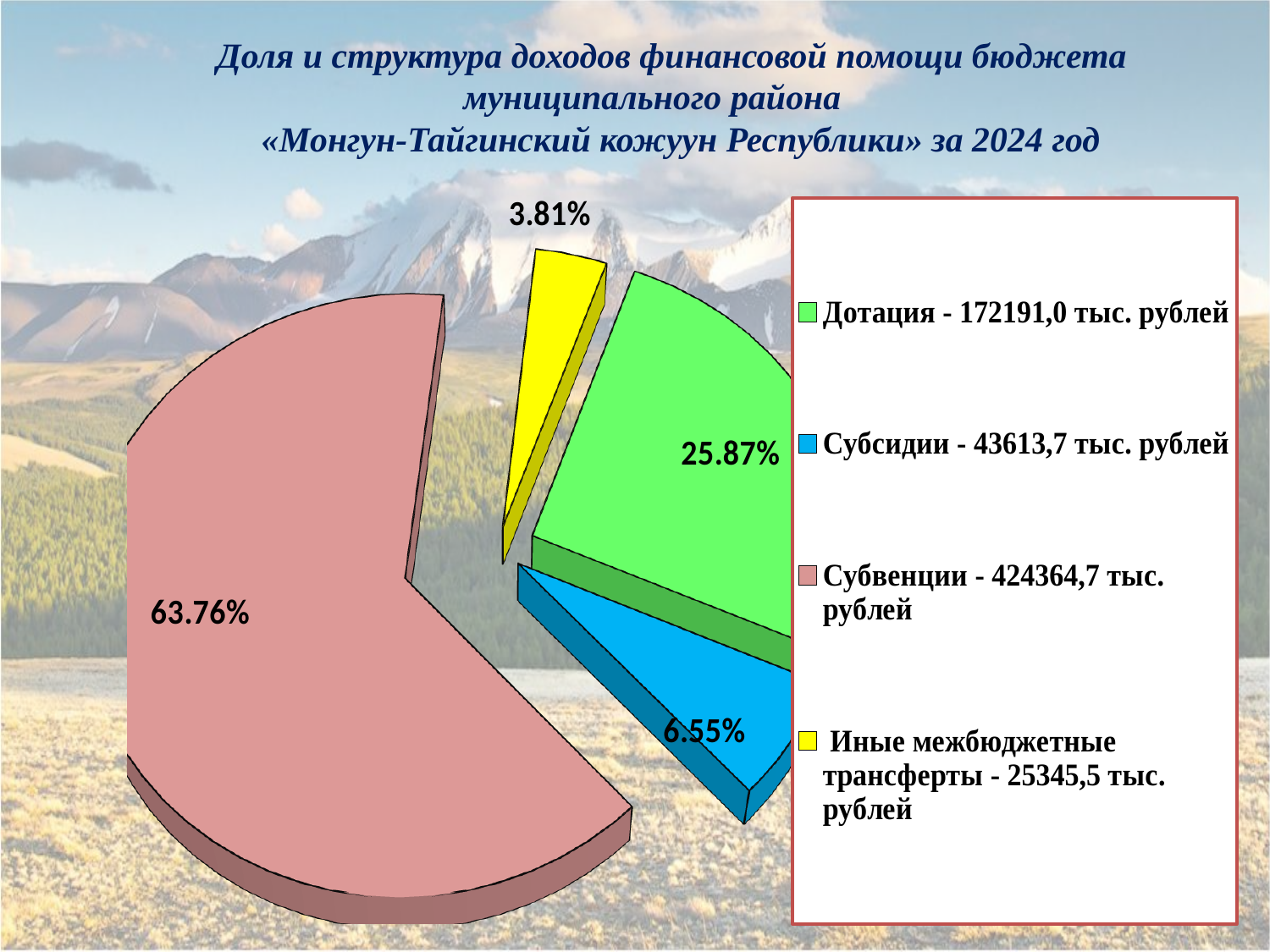
How many slices does the pie chart have? 4 Which colour represents Дотация in the pie chart? green Which category has the smallest slice of the pie? Иные межбюджетные трансферты What share of the pie do Иные межбюджетные трансферты take? 3.81% What kind of chart is shown on the slide? pie chart What is the difference in percentage points between the Субвенции slice and the Дотация slice? 37.89% What amount in тыс. рублей does the legend give for Субсидии? 43613,7 тыс. рублей What share of the pie does Дотация take? 25.87% How many entries does the legend list? 4 Which category has the largest slice of the pie? Субвенции What share of the pie does Субсидии take? 6.55%